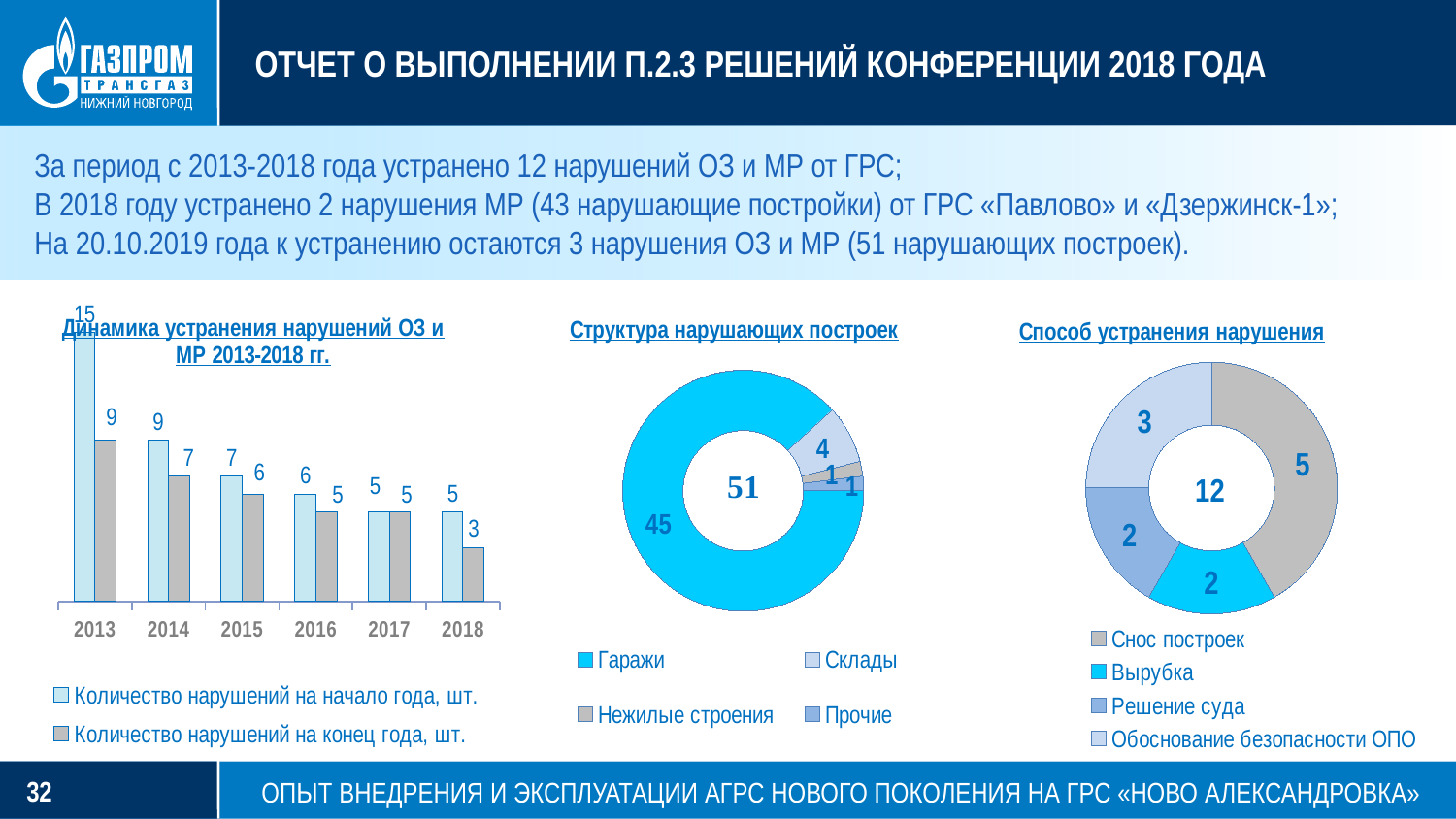
What kind of chart is 'Динамика устранения нарушений ОЗ и МР 2013-2018 гг.'? bar chart In the chart 'Структура нарушающих построек', what is the value for 'Гаражи'? 45 In the chart 'Динамика устранения нарушений ОЗ и МР 2013-2018 гг.', what is the value of 'Количество нарушений на конец года, шт.' for 2018? 3 In the chart 'Динамика устранения нарушений ОЗ и МР 2013-2018 гг.', what is the value of 'Количество нарушений на начало года, шт.' for 2013? 15 In the chart 'Динамика устранения нарушений ОЗ и МР 2013-2018 гг.', how many series does the legend list? 2 In the chart 'Способ устранения нарушения', which is larger: 'Обоснование безопасности ОПО' or 'Вырубка'? Обоснование безопасности ОПО In the chart 'Динамика устранения нарушений ОЗ и МР 2013-2018 гг.', which year has the highest value for 'Количество нарушений на начало года, шт.'? 2013 In the chart 'Динамика устранения нарушений ОЗ и МР 2013-2018 гг.', how many years are shown on the x axis? 6 In the chart 'Динамика устранения нарушений ОЗ и МР 2013-2018 гг.', do the values of 'Количество нарушений на начало года, шт.' rise or fall from 2013 to 2018? fall In the chart 'Динамика устранения нарушений ОЗ и МР 2013-2018 гг.', what is the difference between the start-of-year and end-of-year values for 2013? 6 In the chart 'Способ устранения нарушения', what is the value for 'Снос построек'? 5 In the chart 'Структура нарушающих построек', which category has the largest value? Гаражи